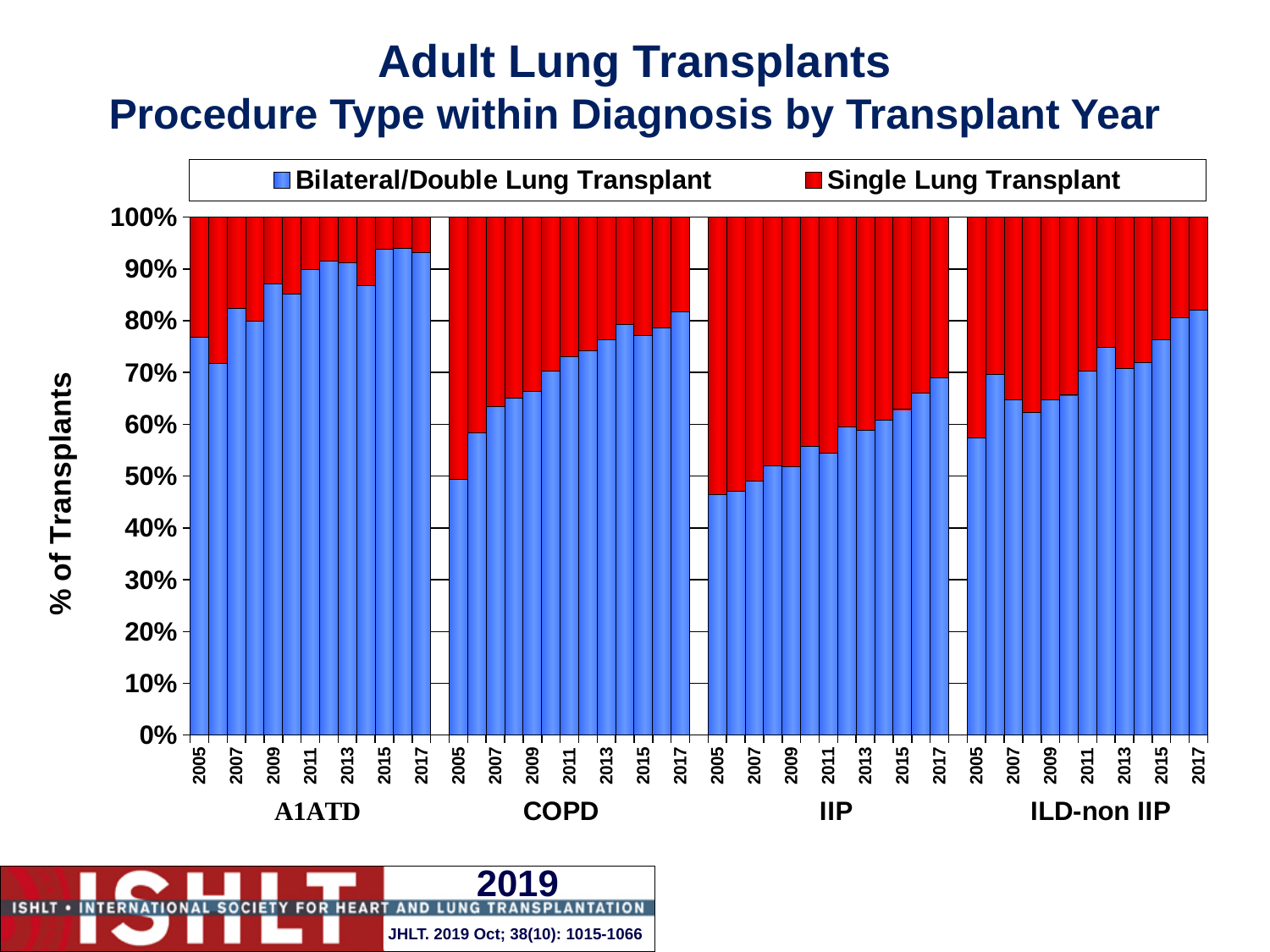
Which colour represents Single Lung Transplant in the chart? Red How many diagnosis groups are shown along the x axis? 4 Within the IIP group, does the Bilateral/Double Lung Transplant share generally rise or fall from 2005 to 2017? rise How many series does the legend list? 2 Is the Bilateral/Double Lung Transplant share for ILD-non IIP in 2017 greater or less than 70%? greater Is the Bilateral/Double Lung Transplant share for IIP in 2005 greater or less than 50%? less Is the Bilateral/Double Lung Transplant share for A1ATD in 2015 greater or less than 90%? greater What kind of chart is shown on the slide? Stacked bar chart How many transplant years are plotted within each diagnosis group? 13 Which is larger: the Bilateral/Double Lung Transplant share for A1ATD in 2005 or for IIP in 2005? A1ATD in 2005 Which diagnosis group has the highest Bilateral/Double Lung Transplant share in 2017? A1ATD